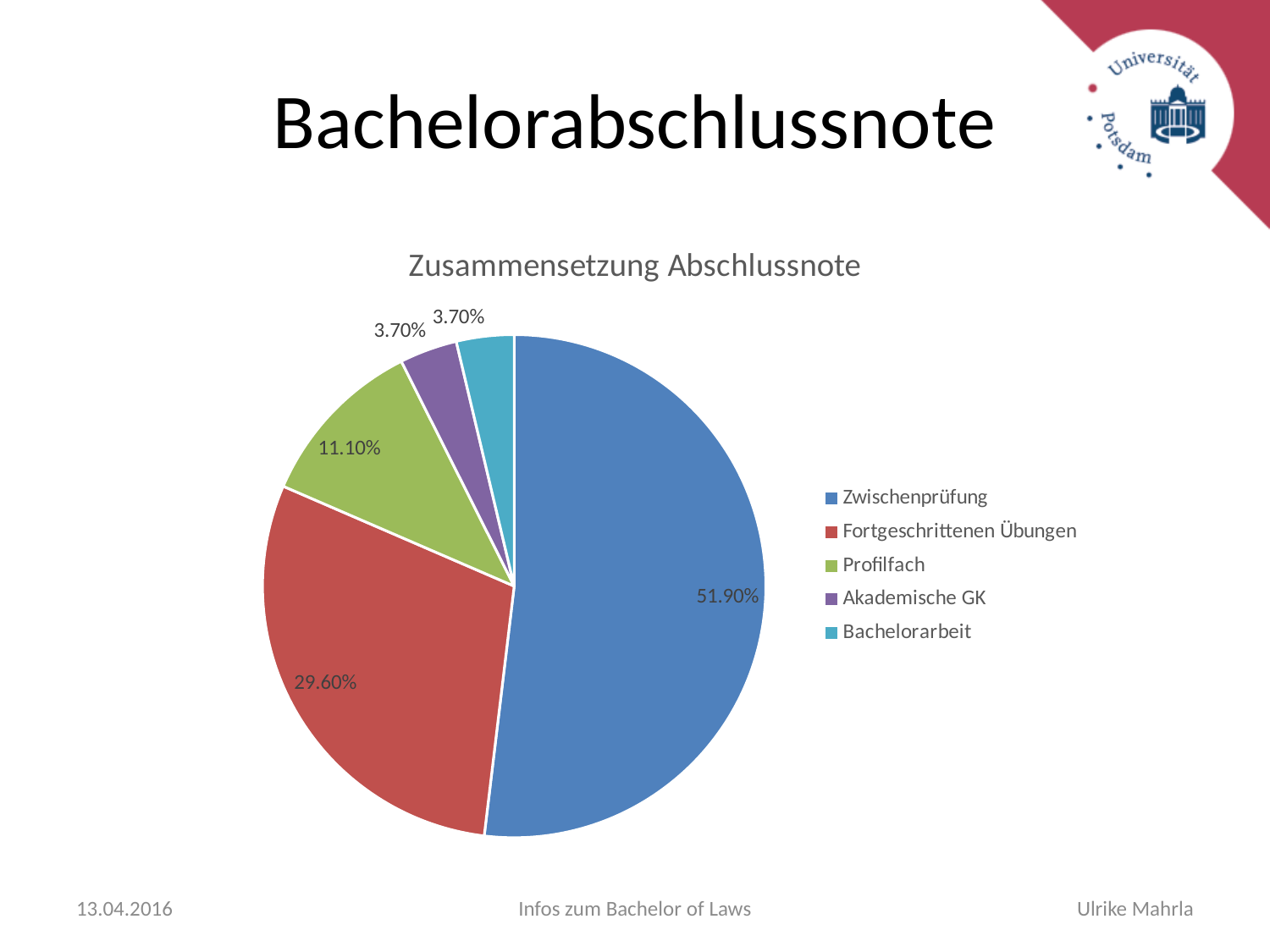
How many slices does the pie chart have? 5 What is the difference in share between Zwischenprüfung and Fortgeschrittenen Übungen? 22.30% What is the title of the chart? Zusammensetzung Abschlussnote How many entries does the legend list? 5 What share of the Abschlussnote does Zwischenprüfung make up? 51.90% What share of the Abschlussnote does Profilfach make up? 11.10% What kind of chart is shown on the slide? pie chart What share of the Abschlussnote does Bachelorarbeit make up? 3.70% Which has a larger share, Profilfach or Akademische GK? Profilfach What share of the Abschlussnote does Fortgeschrittenen Übungen make up? 29.60% Which colour represents Fortgeschrittenen Übungen in the pie chart? red Which component has the largest share of the Abschlussnote? Zwischenprüfung